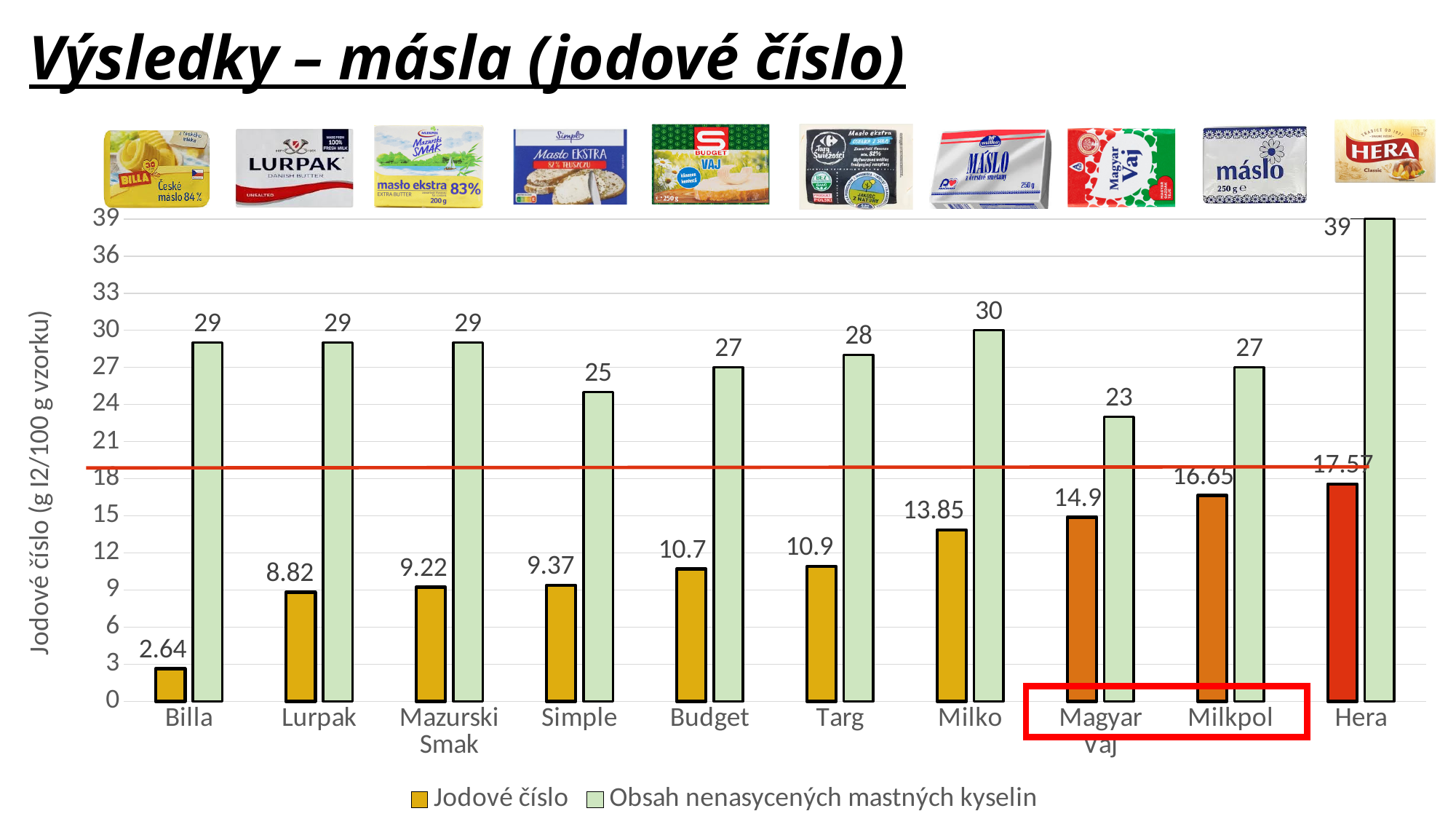
What is the Obsah nenasycených mastných kyselin value for Hera? 39 Which is larger, the Jodové číslo value for Milko or for Magyar Vaj? Magyar Vaj What is the Jodové číslo value for Billa? 2.64 What is the title of the slide? Výsledky – másla (jodové číslo) How many categories are shown on the x axis? 10 What is the difference between the Jodové číslo values for Hera and Billa? 14.93 What is the Jodové číslo value for Milkpol? 16.65 Which category has the lowest Obsah nenasycených mastných kyselin value? Magyar Vaj Do the Jodové číslo values rise or fall from Billa to Hera along the x axis? Rise What kind of chart is shown on the slide? Bar chart Which category has the highest Jodové číslo value? Hera How many series does the legend list? 2